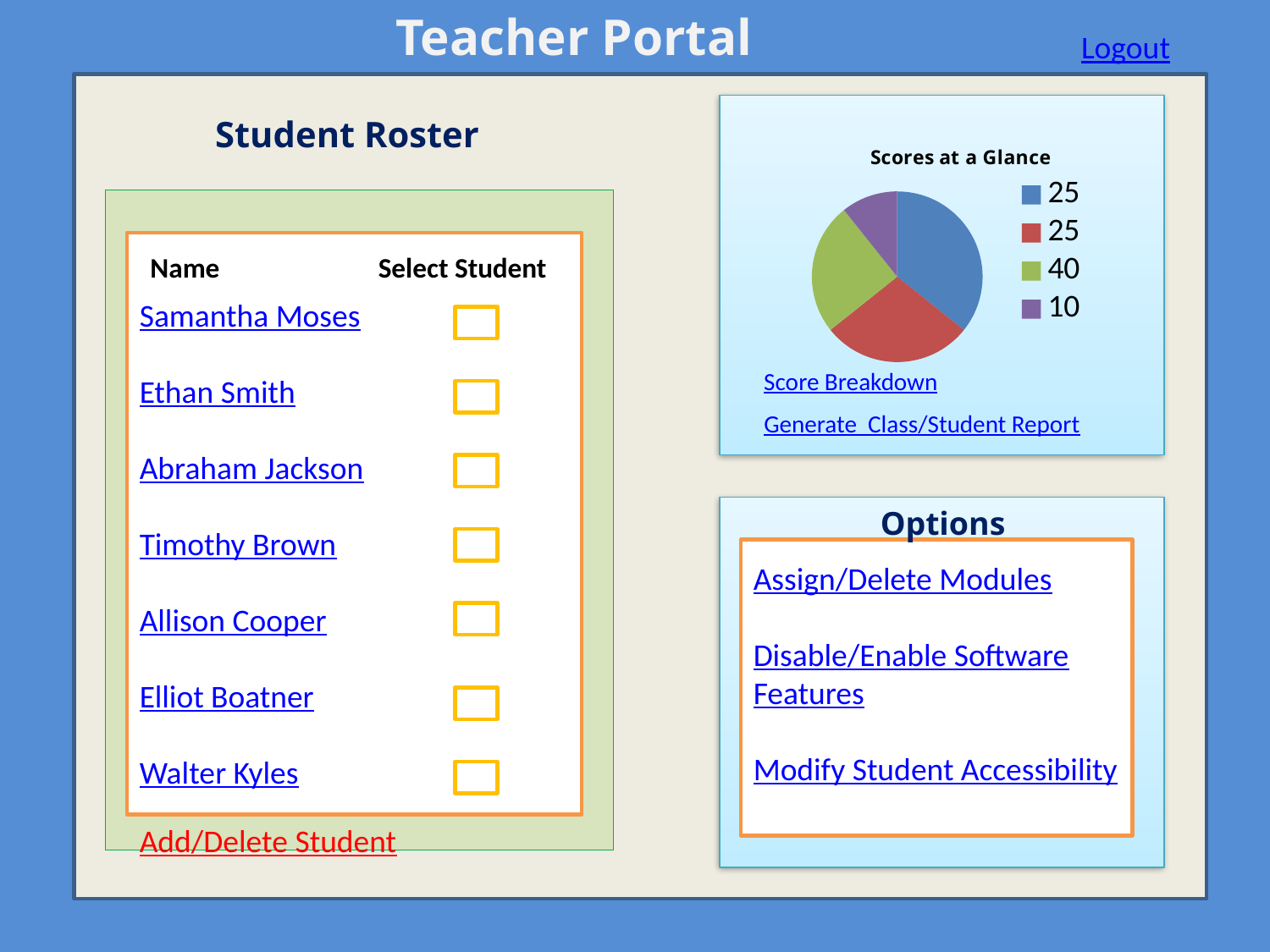
How many slices does the "Scores at a Glance" pie chart have? 4 What is the title of the chart on the slide? Scores at a Glance How many entries does the legend of the "Scores at a Glance" chart list? 4 What kind of chart is shown under "Scores at a Glance"? pie chart What colour is the slice labelled 40 in the "Scores at a Glance" legend? green In the "Scores at a Glance" pie chart, which slice is larger: the one labelled 40 or the one labelled 10? 40 Which legend entry corresponds to the smallest slice of the "Scores at a Glance" pie chart? 10